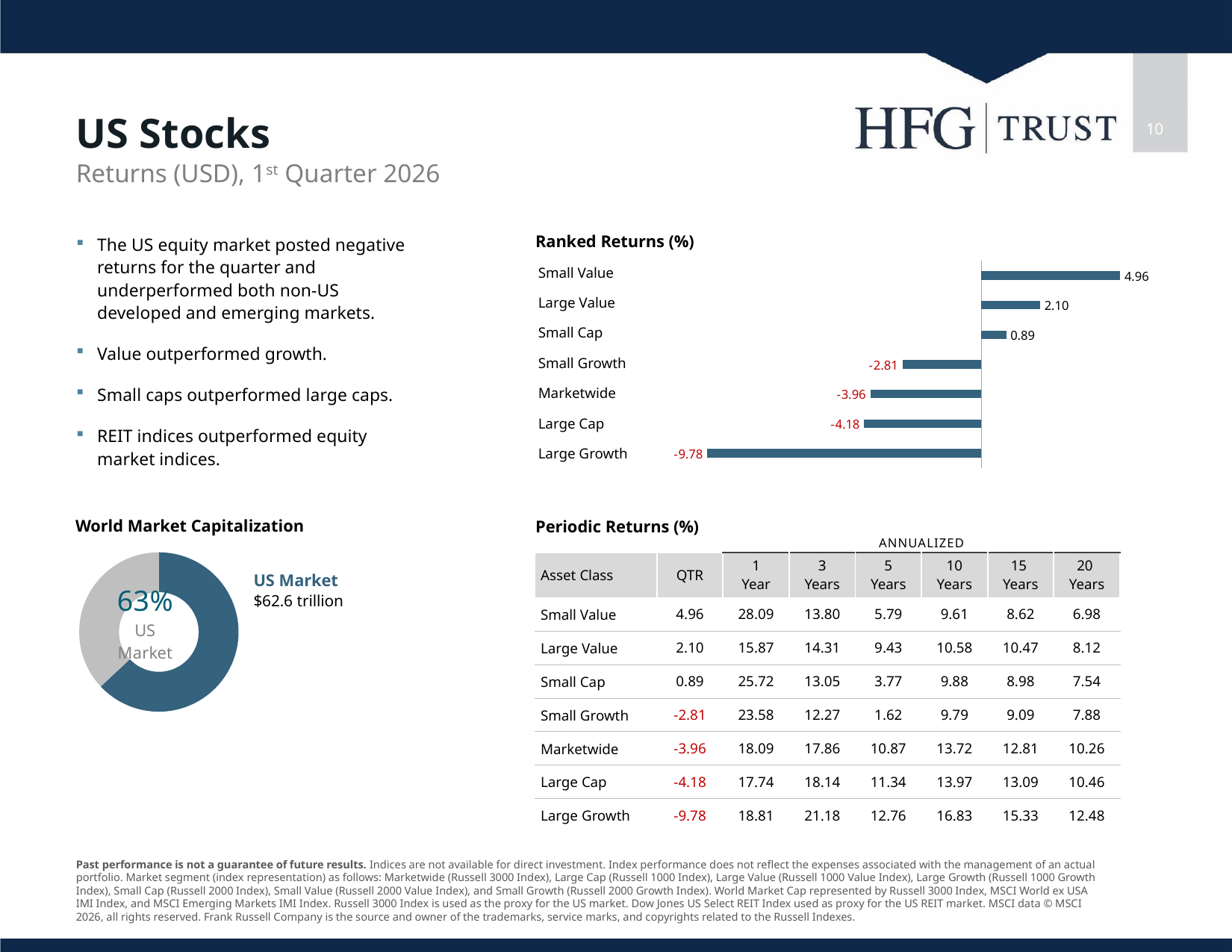
How many categories are shown in the Ranked Returns (%) chart? 7 In the Ranked Returns (%) chart, which category has the highest value? Small Value In the Ranked Returns (%) chart, which category has the lowest value? Large Growth What kind of chart is the Ranked Returns (%) chart? Bar chart In the Ranked Returns (%) chart, what is the value for Small Value? 4.96 In the Ranked Returns (%) chart, how many categories have negative values? 4 In the World Market Capitalization chart, what share of the pie does the US Market represent? 63% In the Ranked Returns (%) chart, what is the value for Marketwide? -3.96 In the Ranked Returns (%) chart, what is the value for Large Growth? -9.78 In the World Market Capitalization chart, what dollar value is shown for the US Market? $62.6 trillion In the Ranked Returns (%) chart, what is the difference between the values for Small Value and Large Value? 2.86 In the Ranked Returns (%) chart, which is larger, the value for Small Growth or the value for Large Cap? Small Growth